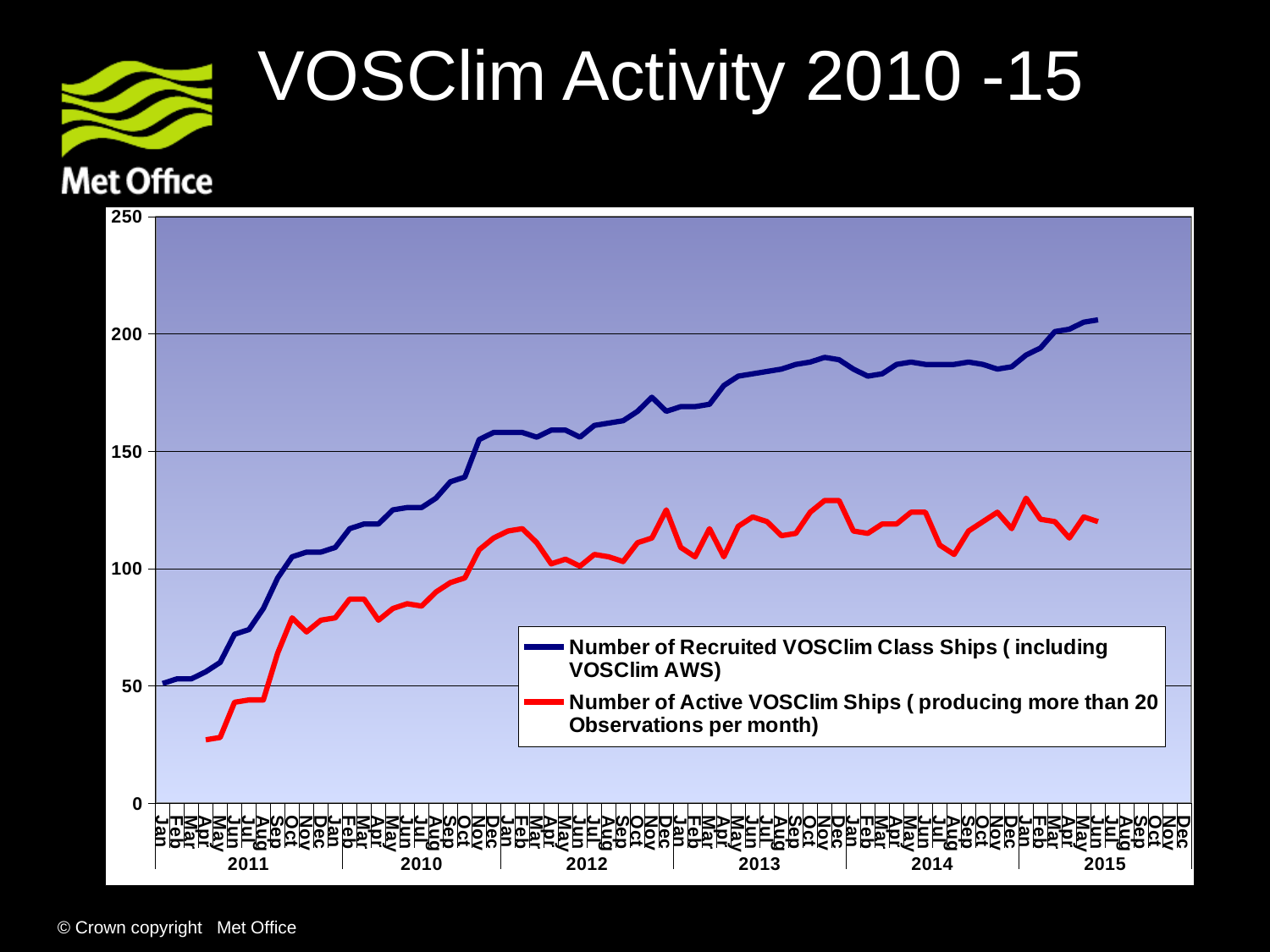
Which series is drawn in red? Number of Active VOSClim Ships ( producing more than 20 Observations per month) Is the number of active VOSClim ships at the start of the series (2011) greater or less than 50? less Which series has the higher values throughout the chart, recruited VOSClim class ships or active VOSClim ships? Number of Recruited VOSClim Class Ships ( including VOSClim AWS) Is the highest value reached by the active VOSClim ships line greater or less than 150? less How many series does the legend list? 2 Is the number of recruited VOSClim class ships in 2013 greater or less than 150? greater What is the title of the slide's chart? VOSClim Activity 2010 -15 Does the number of recruited VOSClim class ships rise or fall over the period shown? rise What is the maximum value shown on the vertical axis? 250 What kind of chart is shown on the slide? line chart